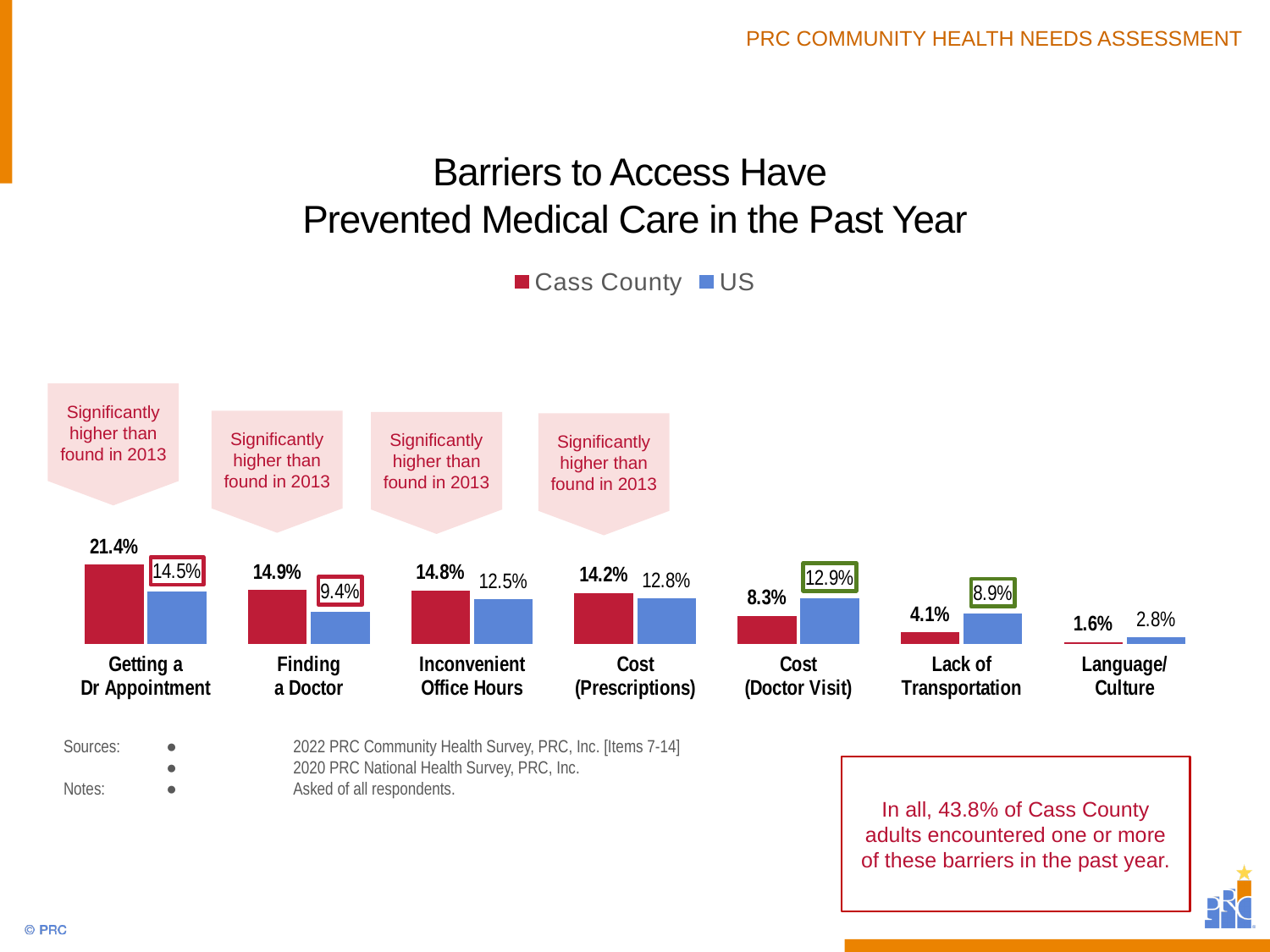
Which series is shown in red in the legend? Cass County What is the US value for Lack of Transportation? 8.9% What kind of chart is shown on the slide? Bar chart Which category has the lowest US value? Language/Culture What is the US value for Finding a Doctor? 9.4% What is the Cass County value for Cost (Doctor Visit)? 8.3% Which category has the highest Cass County value? Getting a Dr Appointment What is the Cass County value for Getting a Dr Appointment? 21.4% How many series does the legend list? 2 What is the difference between the Cass County and US values for Getting a Dr Appointment? 6.9% How many barrier categories are shown on the chart? 7 Which is larger for Cost (Doctor Visit): the Cass County value or the US value? US